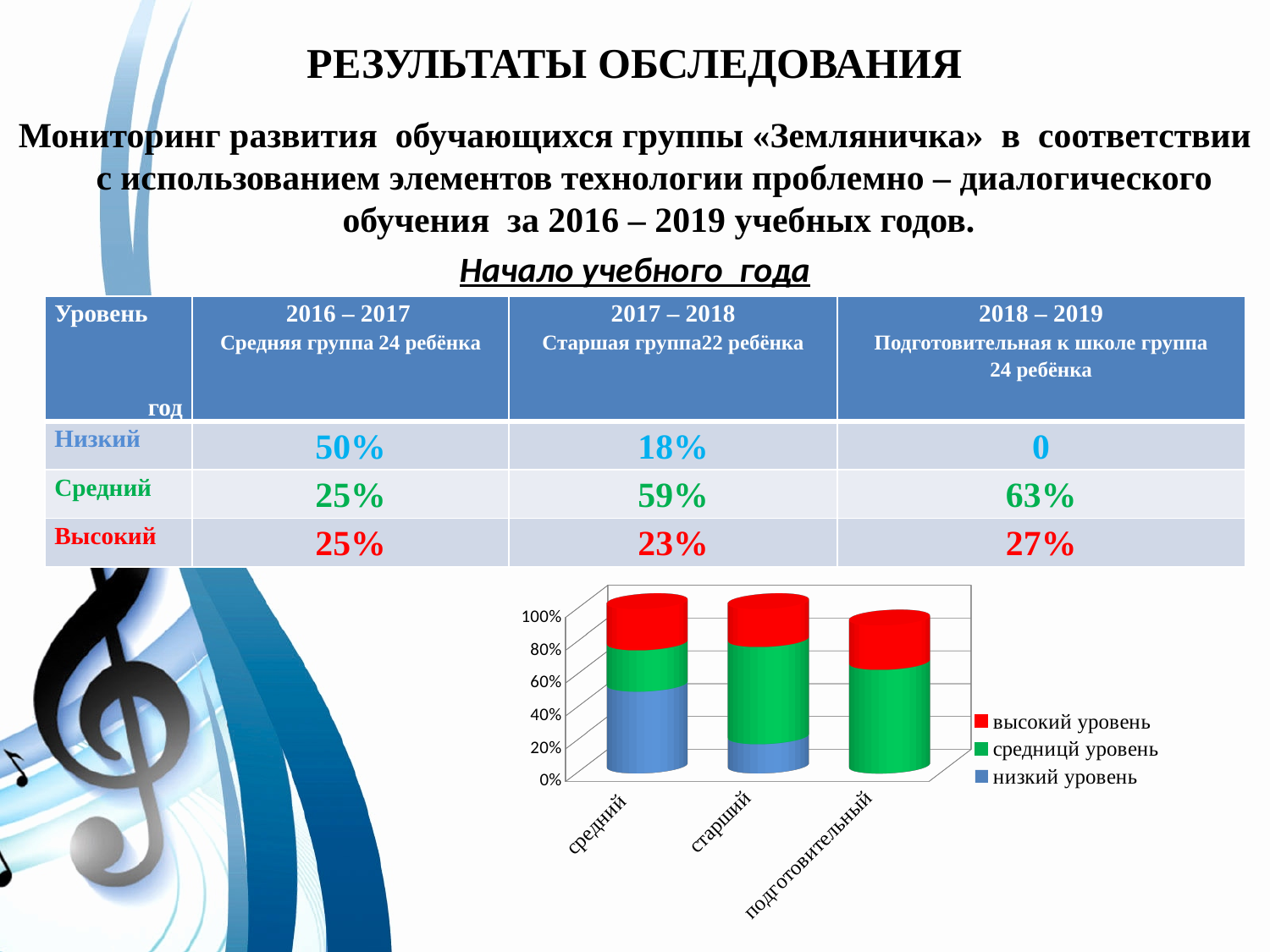
In the chart, is the высокий уровень segment for средний greater or less than 40%? less In the chart, is the низкий уровень segment for старший greater or less than 40%? less What kind of chart is shown at the bottom of the slide? Stacked bar chart In the chart, which has the larger низкий уровень segment, средний or старший? средний How many categories are shown on the x axis of the chart? 3 In the chart, is the низкий уровень segment for средний greater or less than 40%? greater In the chart, which category has the smallest низкий уровень segment? подготовительный In the chart, which category has the largest низкий уровень segment? средний What are the three entries in the chart legend? высокий уровень, средниций уровень, низкий уровень Does the низкий уровень segment rise or fall from средний to подготовительный along the x axis? Falls What colour represents низкий уровень in the chart? Blue How many series does the chart legend list? 3